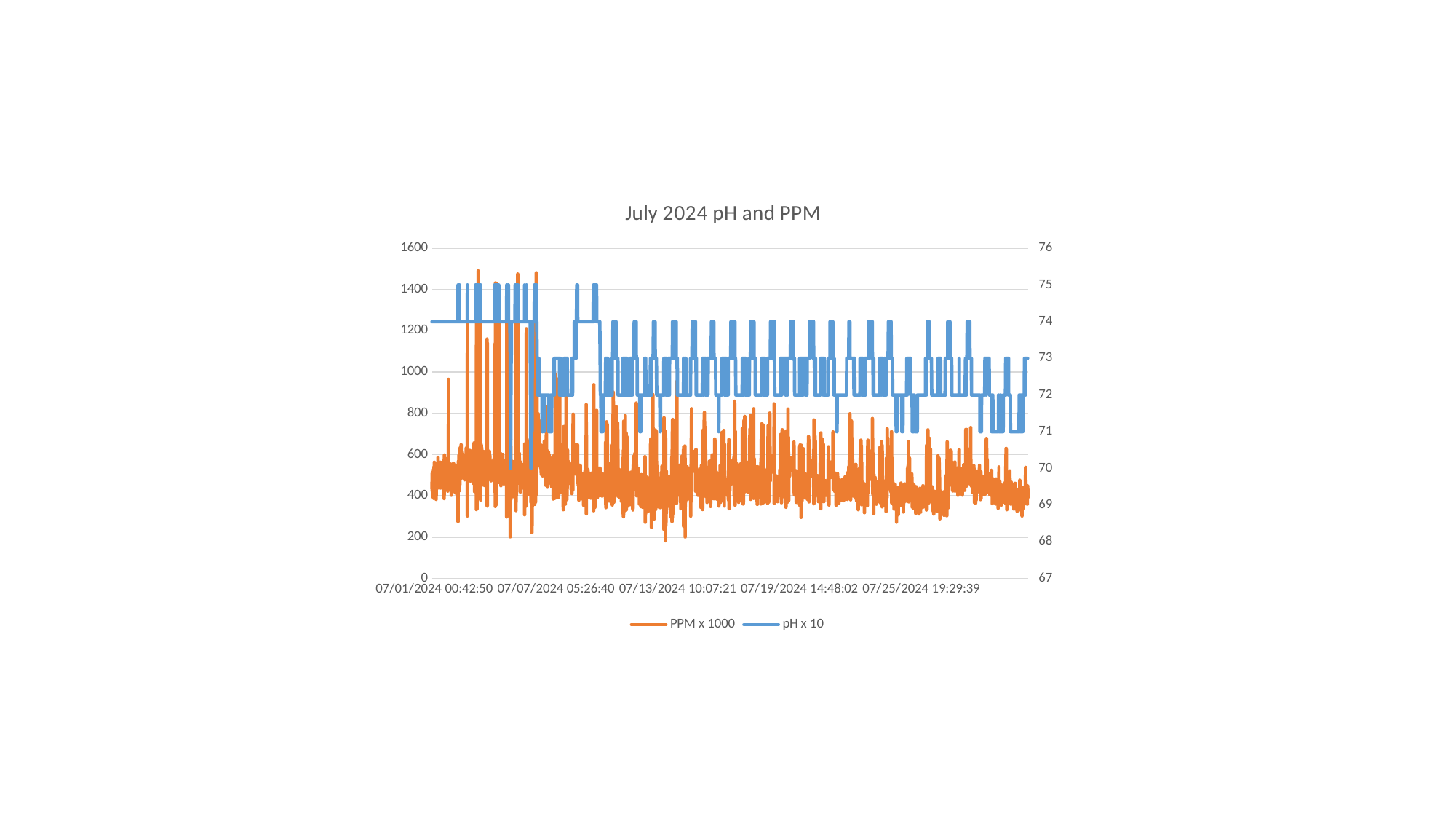
Does the pH x 10 series generally rise or fall from the start of July to the end of July? fall How many series does the legend list? 2 What kind of chart is shown on the slide? line chart Does the pH x 10 series ever drop below 71 during the period? no Do the large spikes in the PPM x 1000 series occur mainly in the first week of July or in the last week of July? first week Which series is drawn in blue? pH x 10 Does the PPM x 1000 series ever exceed 1400 during the period? yes What is the title of the chart? July 2024 pH and PPM Is the pH x 10 value at the end of the period greater or less than 74? less